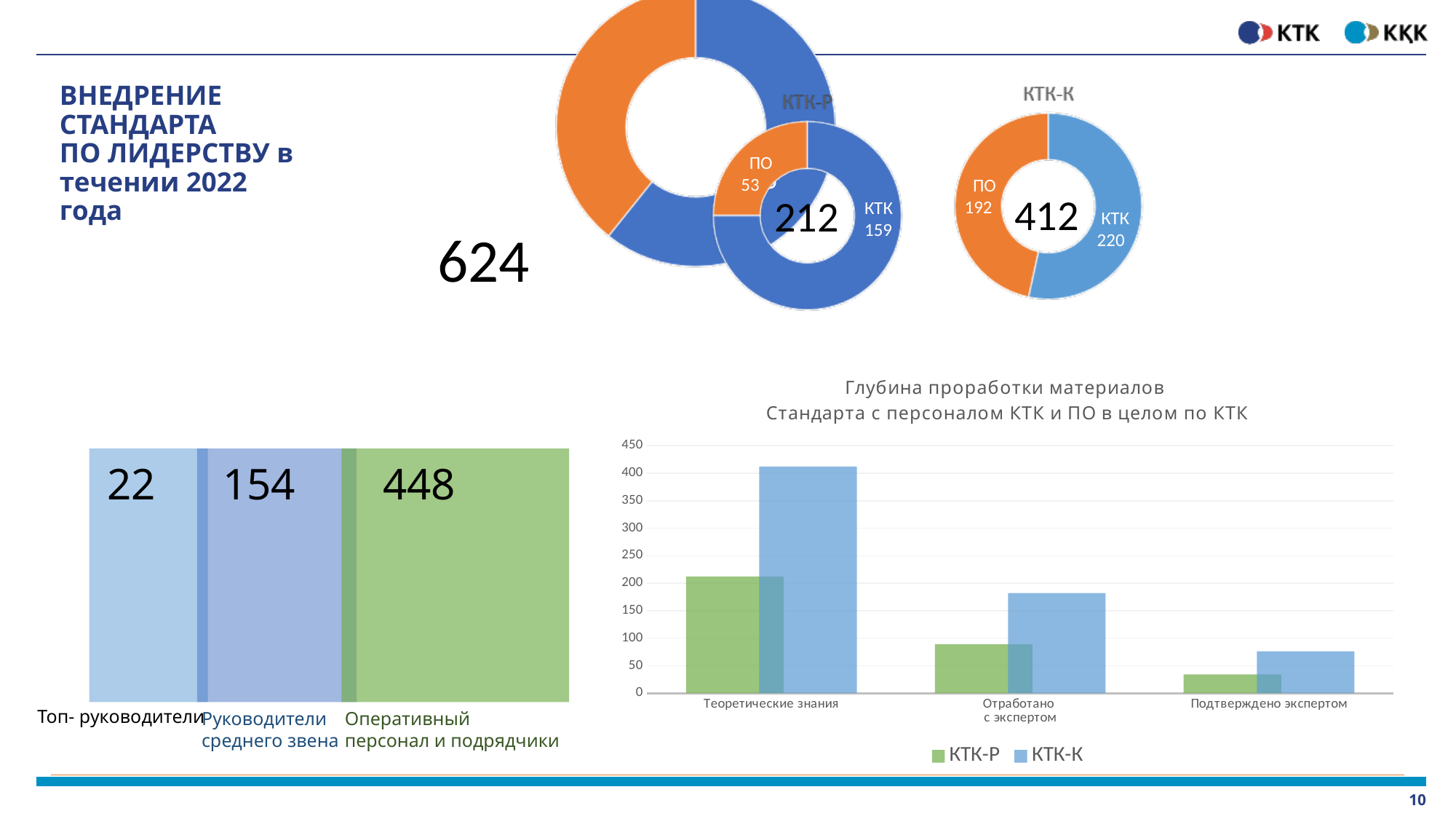
In the horizontal stacked bar at the bottom left, what is the value for Оперативный персонал и подрядчики? 448 In the КТК-Р donut chart, what is the difference between the КТК value and the ПО value? 106 In the КТК-К donut chart, what is the value for ПО? 192 In the chart 'Глубина проработки материалов Стандарта с персоналом КТК и ПО в целом по КТК', do the КТК-К values rise or fall from left to right across the categories? fall In the chart 'Глубина проработки материалов Стандарта с персоналом КТК и ПО в целом по КТК', is the КТК-К value for Теоретические знания greater or less than 400? greater In the КТК-Р donut chart, what is the value for КТК? 159 In the chart 'Глубина проработки материалов Стандарта с персоналом КТК и ПО в целом по КТК', how many series does the legend list? 2 In the horizontal stacked bar at the bottom left, which category has the lowest value? Топ- руководители In the horizontal stacked bar at the bottom left, what is the total of all three segments? 624 In the КТК-Р donut chart, what is the value for ПО? 53 In the chart 'Глубина проработки материалов Стандарта с персоналом КТК и ПО в целом по КТК', is the КТК-Р value for Отработано с экспертом greater or less than 100? less In the КТК-К donut chart, which segment is larger, ПО or КТК? КТК